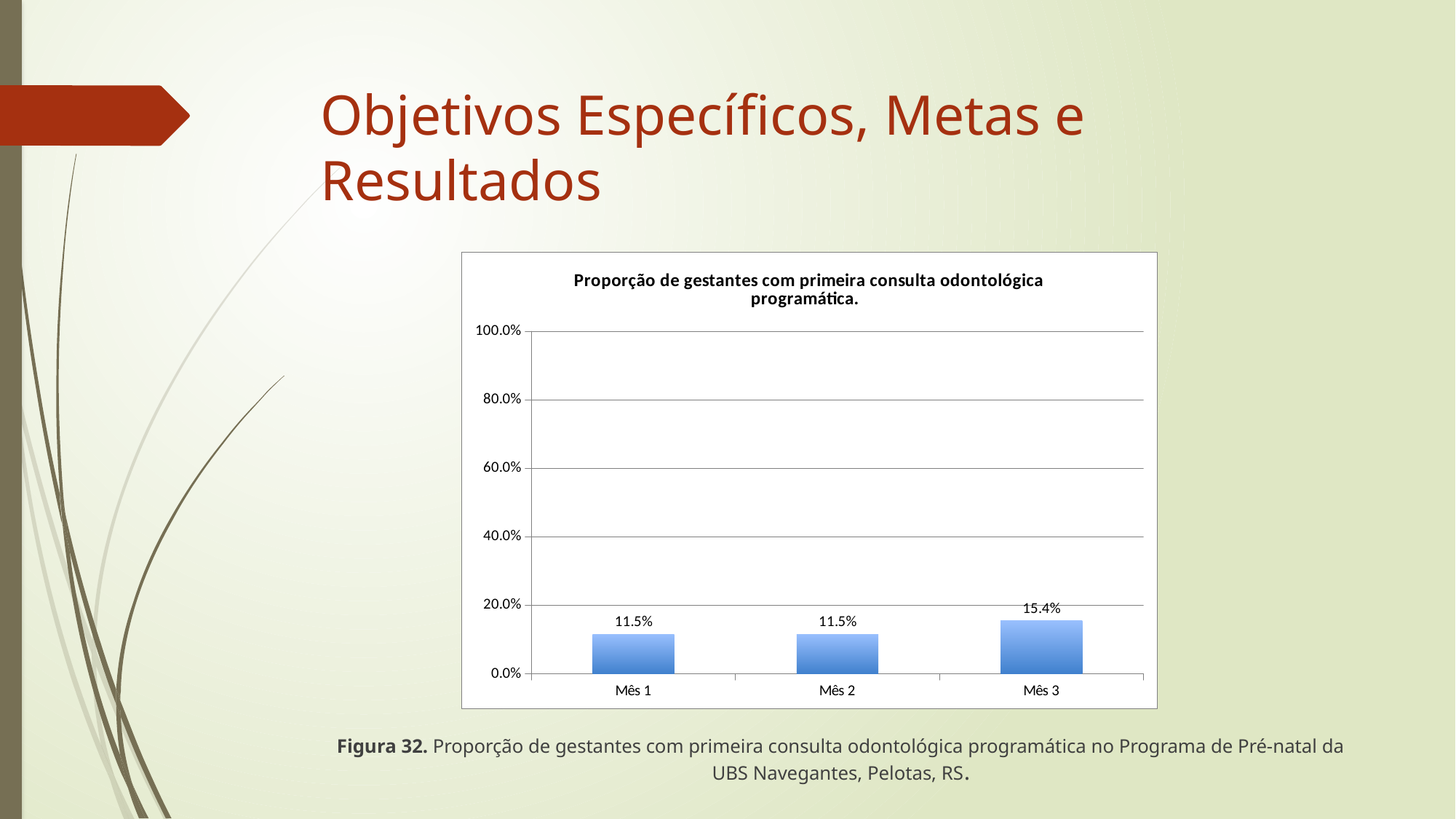
Is the value for Mês 3 greater or less than 20.0%? less What is the title of the chart? Proporção de gestantes com primeira consulta odontológica programática. What is the value for Mês 1? 11.5% Are the values for Mês 1 and Mês 2 the same or different? the same What is the value for Mês 3? 15.4% How many months are shown on the x axis? 3 What is the difference between the values for Mês 3 and Mês 2? 3.9% Which month has the highest value? Mês 3 Which is larger, the value for Mês 3 or the value for Mês 1? Mês 3 Do the values rise or fall from Mês 2 to Mês 3? rise What kind of chart is shown on the slide? bar chart What is the highest value shown on the y axis? 100.0%